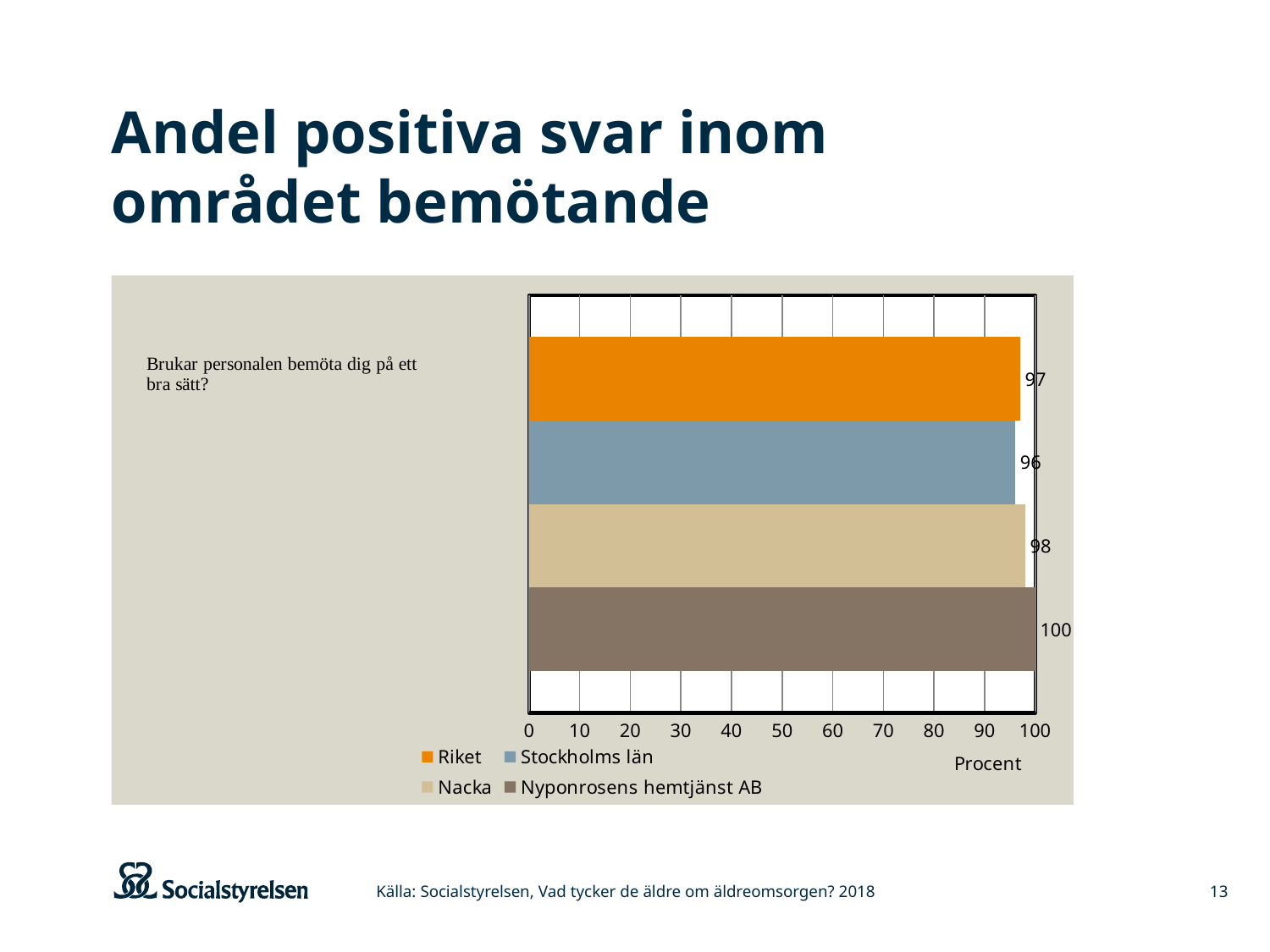
What is the value for Riket? 97 How many series does the legend list? 4 What is the difference between the values for Nyponrosens hemtjänst AB and Stockholms län? 4 Which is larger, the value for Nacka or the value for Riket? Nacka Which series has the highest value? Nyponrosens hemtjänst AB What is the value for Nacka? 98 What is the value for Stockholms län? 96 What is the label of the x axis? Procent What is the value for Nyponrosens hemtjänst AB? 100 Which series has the lowest value? Stockholms län What kind of chart is shown on the slide? Bar chart What is the difference between the values for Nacka and Riket? 1